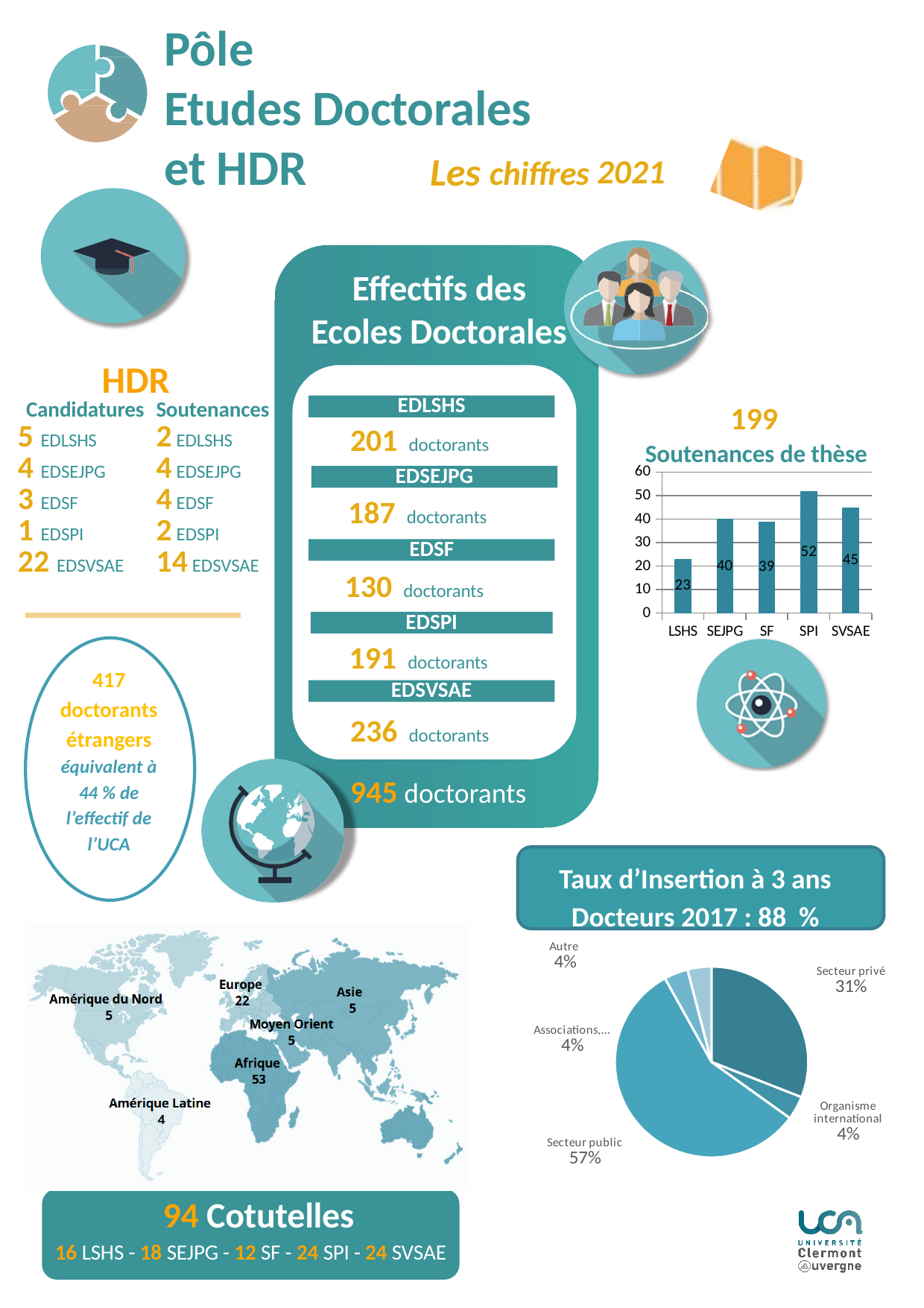
In the 'Soutenances de thèse' bar chart, how many soutenances are shown for SPI? 52 What type of chart is the 'Taux d'Insertion à 3 ans' chart? pie chart In the 'Taux d'Insertion à 3 ans' pie chart, what share is shown for Secteur public? 57% In the 'Soutenances de thèse' bar chart, what is the difference between the values for SPI and SVSAE? 7 In the 'Soutenances de thèse' bar chart, what is the value for LSHS? 23 In the 'Taux d'Insertion à 3 ans' pie chart, what share is shown for Secteur privé? 31% In the 'Taux d'Insertion à 3 ans' pie chart, which slice is the largest? Secteur public What type of chart is the 'Soutenances de thèse' chart? bar chart In the 'Soutenances de thèse' bar chart, how many categories are shown on the x axis? 5 In the 'Soutenances de thèse' bar chart, which category has the lowest value? LSHS In the 'Soutenances de thèse' bar chart, is the value for SVSAE greater or less than 40? greater In the 'Soutenances de thèse' bar chart, which category has the highest value? SPI